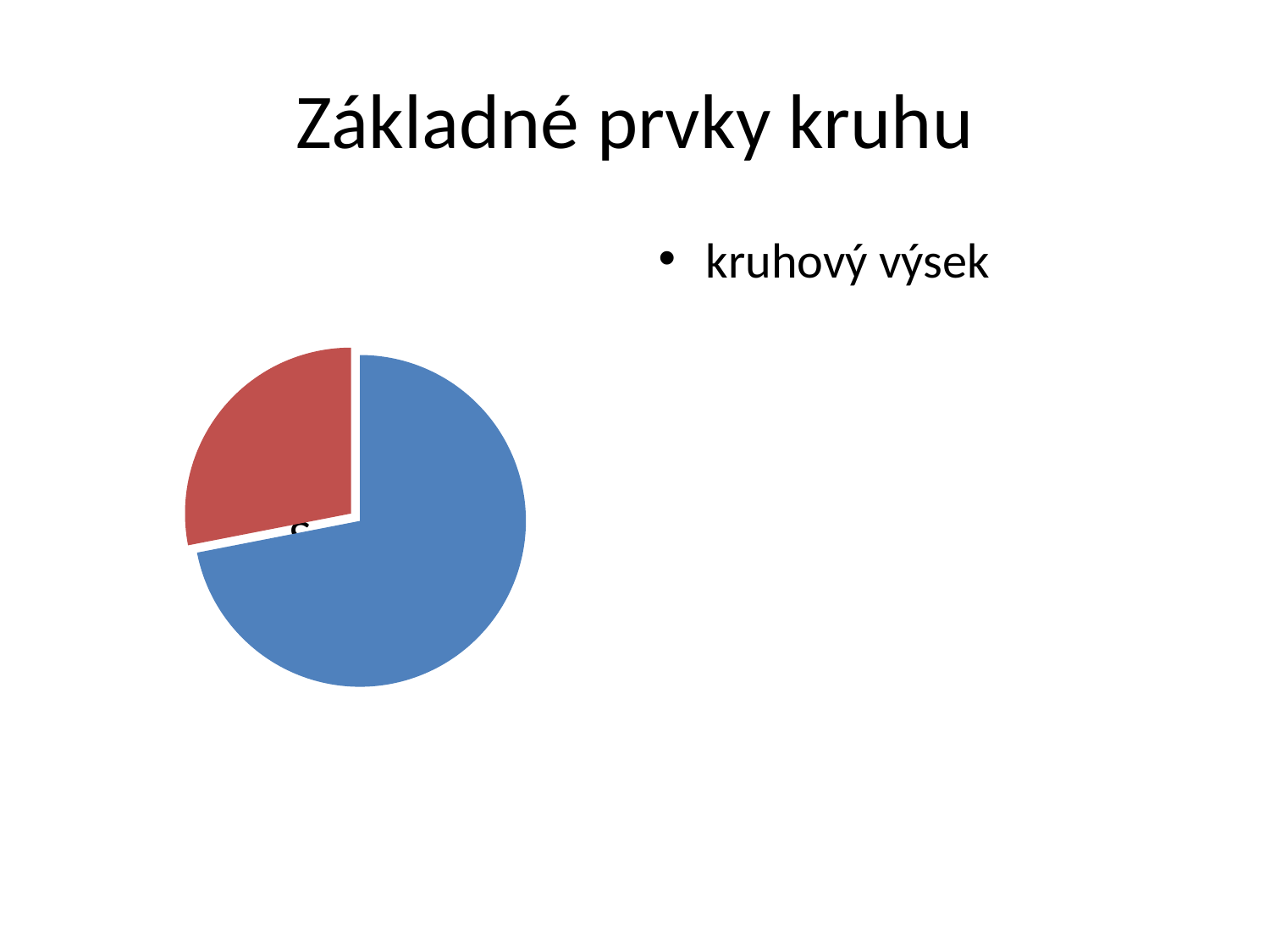
Which colour is the smallest slice of the pie chart? red Which slice of the pie chart is larger, the blue one or the red one? the blue one Does the pie chart display a legend? No Is the blue slice of the pie chart greater or less than half of the pie? greater What kind of chart is shown on the slide? pie chart How many slices does the pie chart have? 2 Which colour is the largest slice of the pie chart? blue Which slice of the pie chart is pulled out (exploded) from the rest of the pie? the red slice Is the red slice of the pie chart greater or less than half of the pie? less